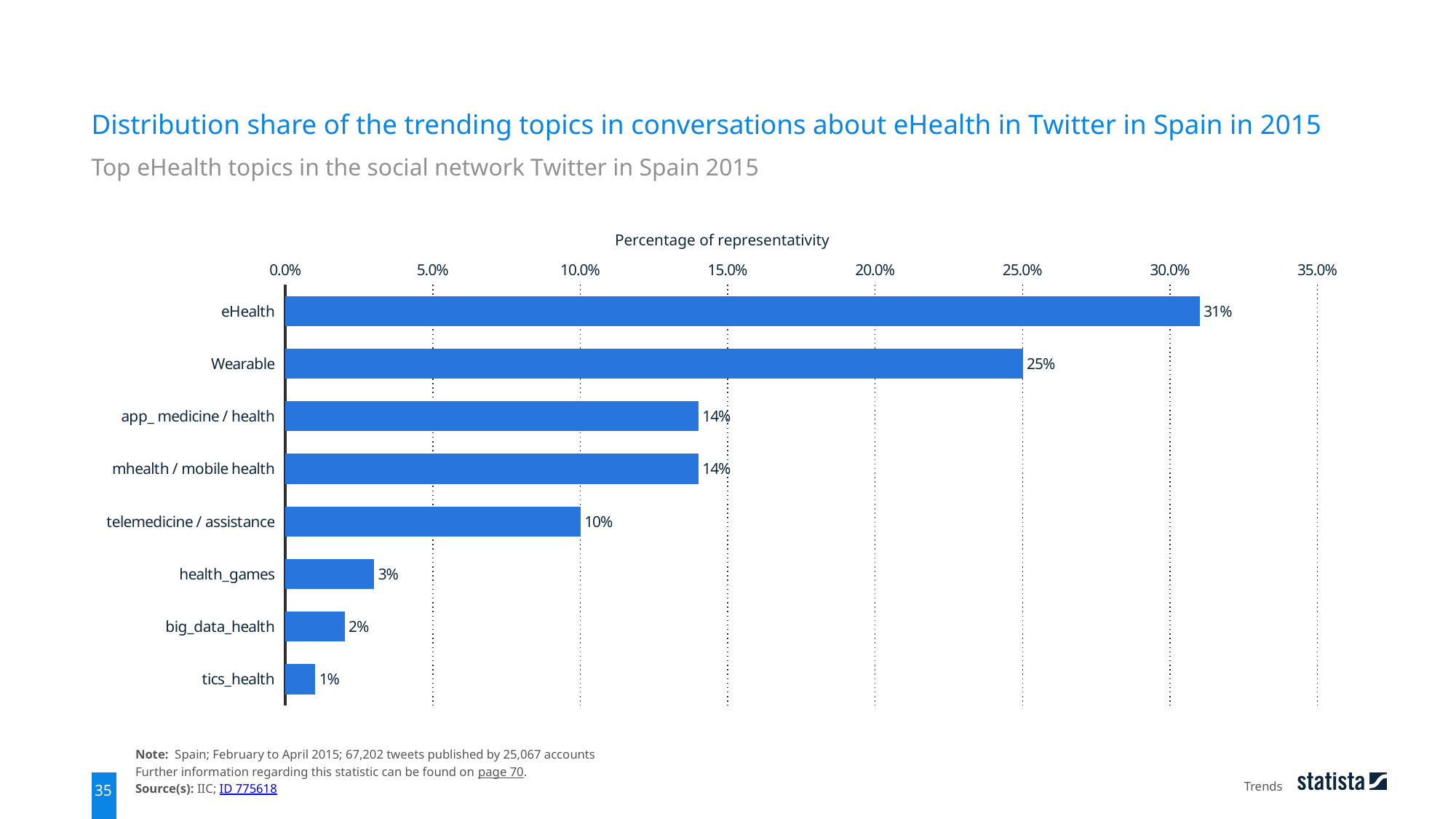
What is the percentage of representativity for eHealth? 31% What is the difference in percentage points between eHealth and Wearable? 6 Which topic has the lowest percentage of representativity? tics_health What kind of chart is shown on the slide? Bar chart What is the percentage of representativity for telemedicine / assistance? 10% What is the percentage of representativity for Wearable? 25% Which has a larger percentage of representativity, telemedicine / assistance or health_games? telemedicine / assistance What is the label of the horizontal axis? Percentage of representativity Which topic has the highest percentage of representativity? eHealth Is the value for Wearable greater or less than 20.0%? greater What is the percentage of representativity for big_data_health? 2% How many topics are shown in the chart? 8